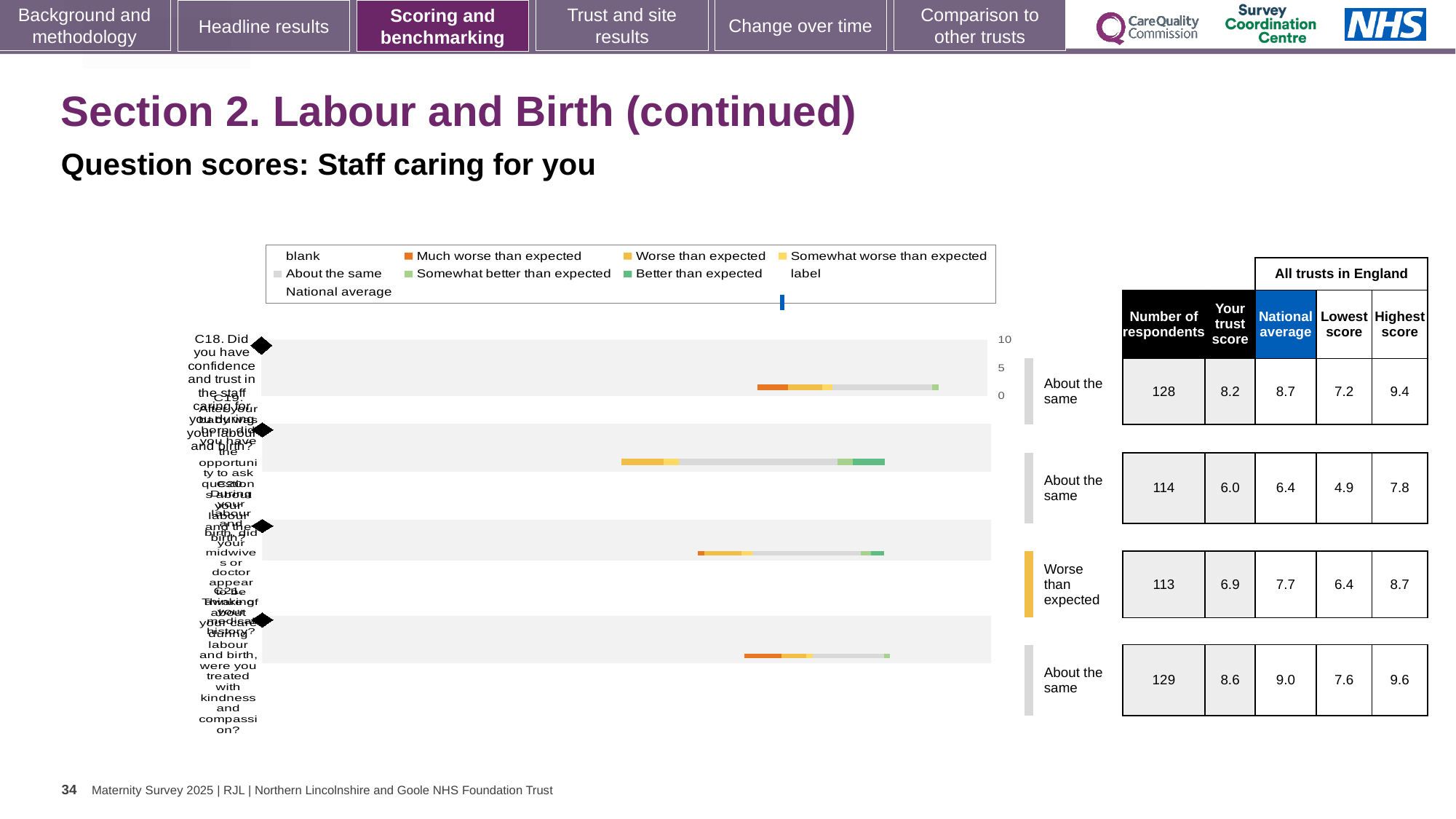
What is the highest 'Your trust score' shown in the table? 8.6 How many question bars are plotted in the chart? 4 For the question rated 'Worse than expected', what is the difference between the national average and the trust score? 0.8 What kind of chart is shown on the slide? bar chart What is the subtitle describing the question scores on this slide? Question scores: Staff caring for you What is the 'Highest score' for the row with 129 respondents? 9.6 In the table, how many respondents are there for the question rated 'Worse than expected'? 113 For the row with 128 respondents, which is larger: the trust score or the national average? National average What is the national average for the question rated 'Worse than expected'? 7.7 What is 'Your trust score' for the question rated 'Worse than expected'? 6.9 What colour represents 'Much worse than expected' in the legend? Orange What is the smallest value in the 'Lowest score' column of the table? 4.9